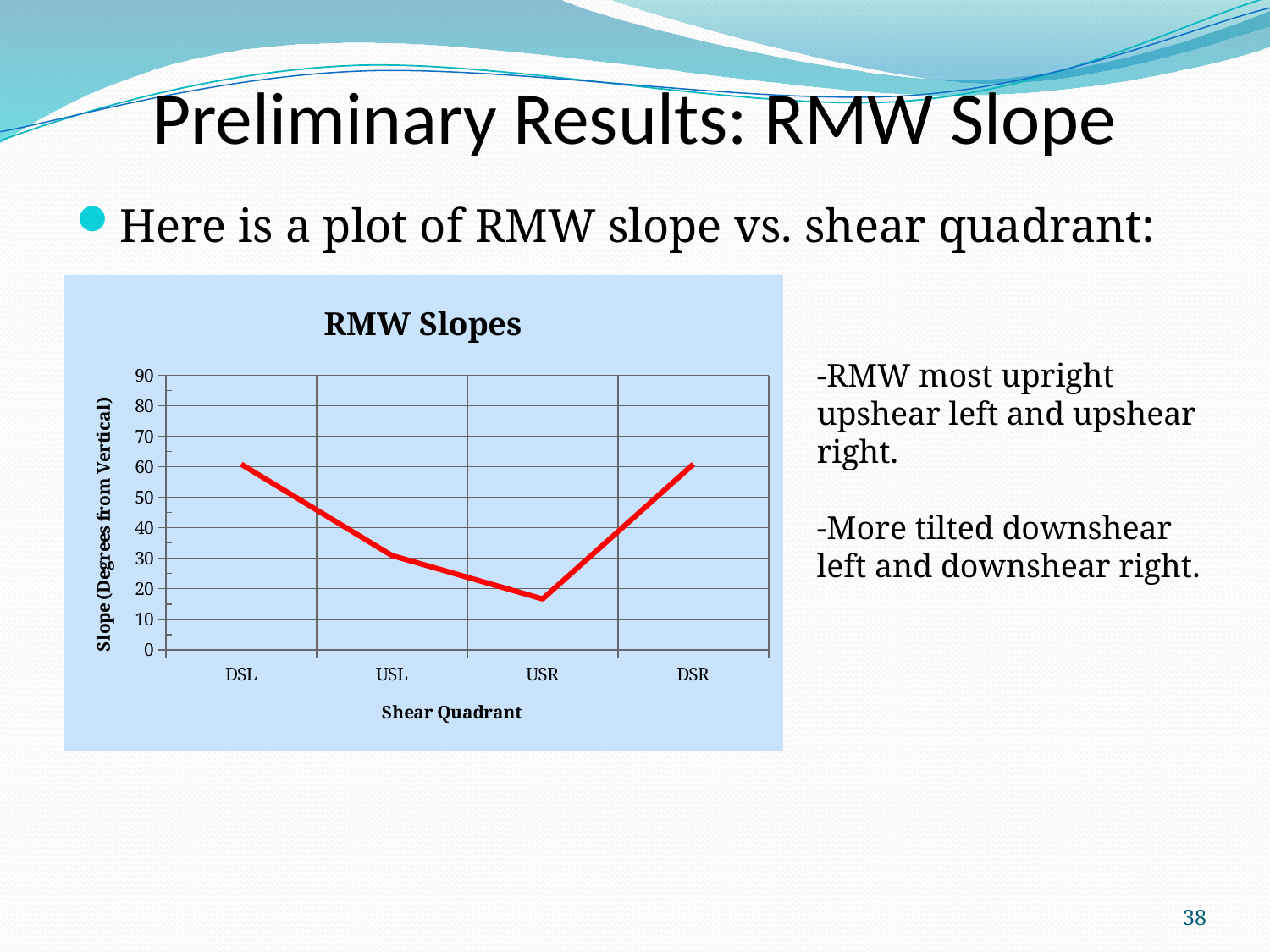
Does the RMW slope rise or fall along the x axis from DSL to USR? fall What is the label of the y axis of the chart? Slope (Degrees from Vertical) Is the value for USL greater or less than 40? less What is the title of the chart? RMW Slopes Is the value for USR greater or less than 20? less Which has the larger RMW slope, USL or USR? USL What kind of chart is shown on the slide? line chart Is the value for DSL greater or less than 50? greater How many shear quadrant categories are plotted on the x axis? 4 Which has the larger RMW slope, DSL or USL? DSL Which shear quadrant has the lowest RMW slope? USR